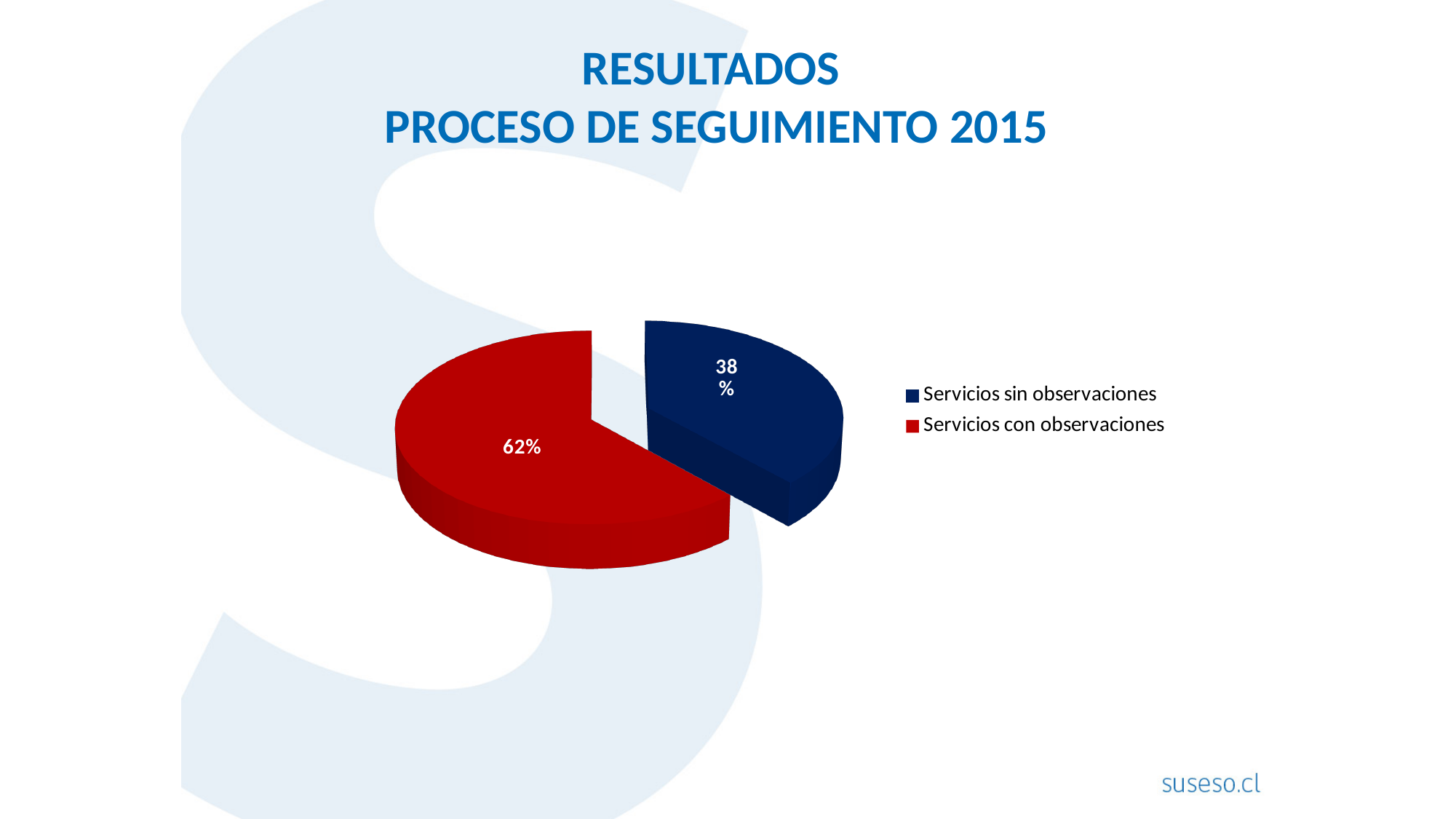
What share of the pie is 'Servicios sin observaciones'? 38% What kind of chart is shown on the slide? pie chart What colour is the slice for 'Servicios sin observaciones'? dark blue How many slices does the pie chart have? 2 Which category has the smallest slice of the pie? Servicios sin observaciones What colour is the slice for 'Servicios con observaciones'? red Which category has the largest slice of the pie? Servicios con observaciones Which is larger: 'Servicios sin observaciones' or 'Servicios con observaciones'? Servicios con observaciones How many entries does the legend list? 2 What is the difference in percentage points between 'Servicios con observaciones' and 'Servicios sin observaciones'? 24 What share of the pie is 'Servicios con observaciones'? 62%